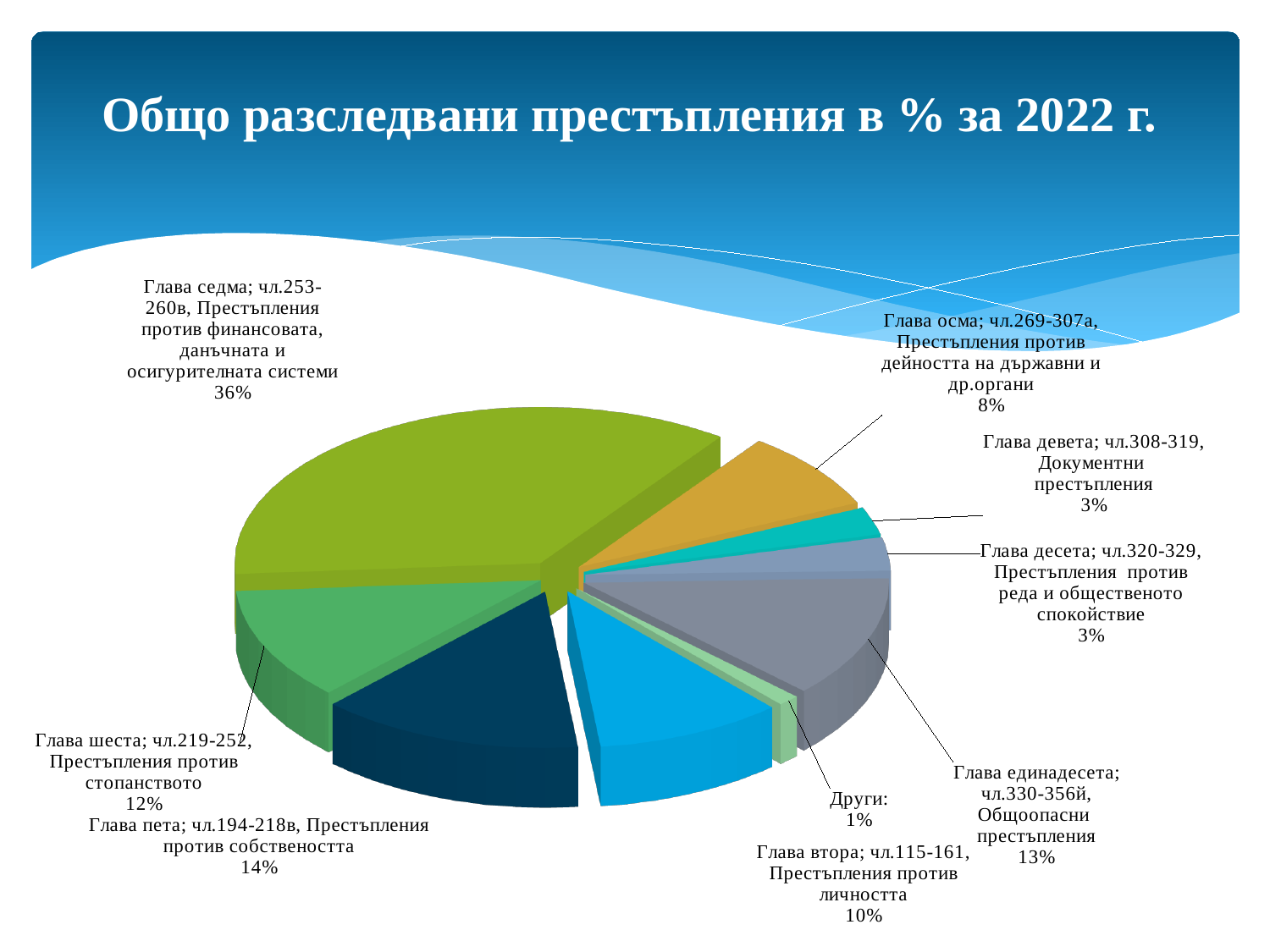
Which category has the smallest share of the pie? Други What percentage is shown for Глава втора (чл.115-161, Престъпления против личността)? 10% What percentage is shown for Глава седма (чл.253-260в, Престъпления против финансовата, данъчната и осигурителната системи)? 36% How many slices does the pie chart have? 9 What is the difference in percentage points between Глава пета (14%) and Глава шеста (12%)? 2 Which category has the largest share of the pie? Глава седма; чл.253-260в, Престъпления против финансовата, данъчната и осигурителната системи What percentage is shown for Други? 1% What percentage is shown for Глава единадесета (чл.330-356й, Общоопасни престъпления)? 13% What is the title of the chart on the slide? Общо разследвани престъпления в % за 2022 г. Which is larger: the share for Глава осма or the share for Глава девета? Глава осма What is the combined share of Глава девета and Глава десета? 6% What type of chart is shown on the slide? Pie chart